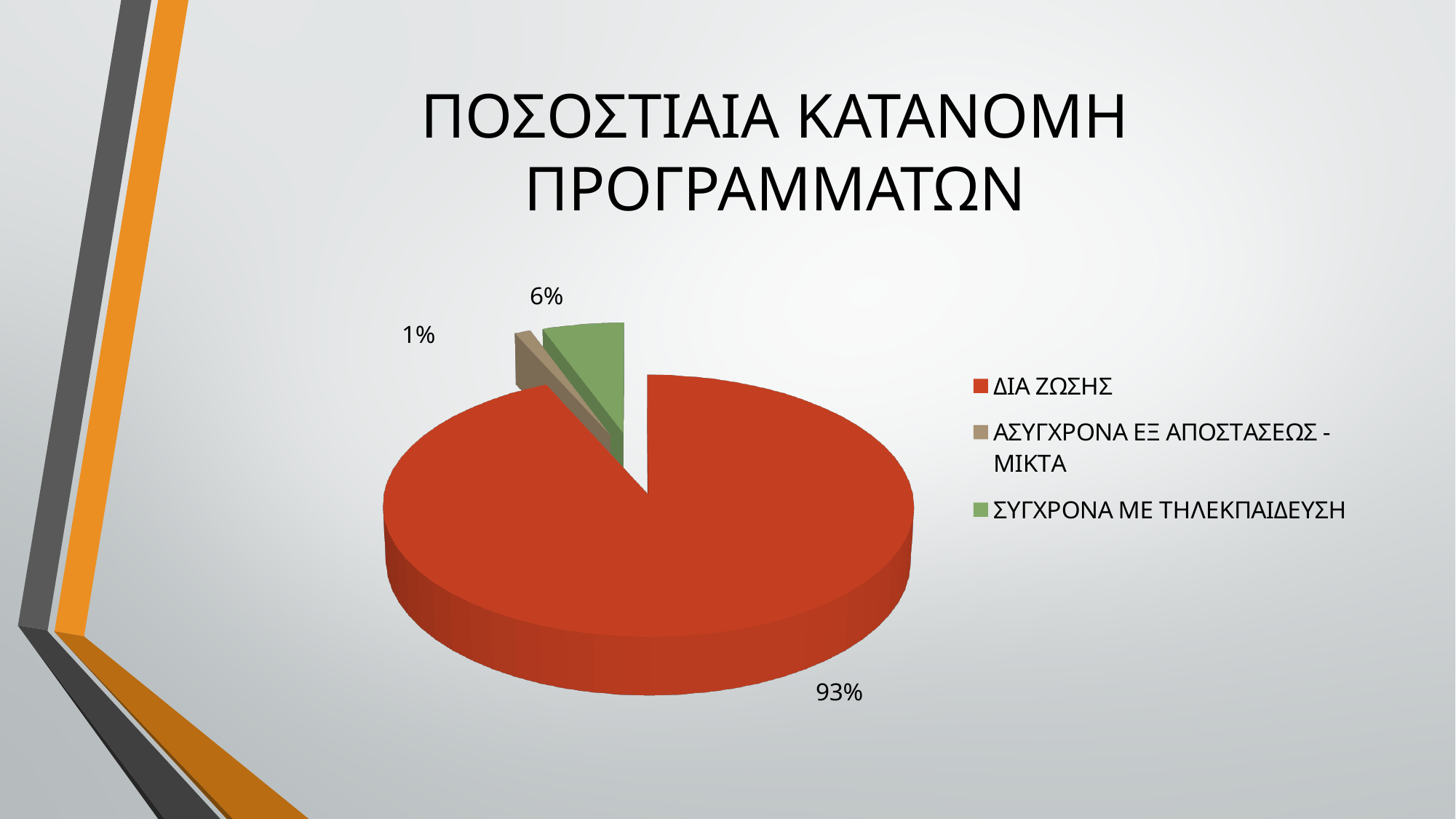
What is the title of the slide? ΠΟΣΟΣΤΙΑΙΑ ΚΑΤΑΝΟΜΗ ΠΡΟΓΡΑΜΜΑΤΩΝ What is the difference in percentage points between ΣΥΓΧΡΟΝΑ ΜΕ ΤΗΛΕΚΠΑΙΔΕΥΣΗ and ΑΣΥΓΧΡΟΝΑ ΕΞ ΑΠΟΣΤΑΣΕΩΣ - ΜΙΚΤΑ? 5% What share of the pie does ΣΥΓΧΡΟΝΑ ΜΕ ΤΗΛΕΚΠΑΙΔΕΥΣΗ represent? 6% Which is larger, the slice for ΣΥΓΧΡΟΝΑ ΜΕ ΤΗΛΕΚΠΑΙΔΕΥΣΗ or the slice for ΑΣΥΓΧΡΟΝΑ ΕΞ ΑΠΟΣΤΑΣΕΩΣ - ΜΙΚΤΑ? ΣΥΓΧΡΟΝΑ ΜΕ ΤΗΛΕΚΠΑΙΔΕΥΣΗ Which category has the smallest slice of the pie? ΑΣΥΓΧΡΟΝΑ ΕΞ ΑΠΟΣΤΑΣΕΩΣ - ΜΙΚΤΑ How many categories are shown in the pie chart? 3 What is the difference in percentage points between ΔΙΑ ΖΩΣΗΣ and ΣΥΓΧΡΟΝΑ ΜΕ ΤΗΛΕΚΠΑΙΔΕΥΣΗ? 87% What share of the pie does ΑΣΥΓΧΡΟΝΑ ΕΞ ΑΠΟΣΤΑΣΕΩΣ - ΜΙΚΤΑ represent? 1% What kind of chart is shown on the slide? Pie chart Which category has the largest slice of the pie? ΔΙΑ ΖΩΣΗΣ What colour is the slice for ΔΙΑ ΖΩΣΗΣ? Red What share of the pie does ΔΙΑ ΖΩΣΗΣ represent? 93%